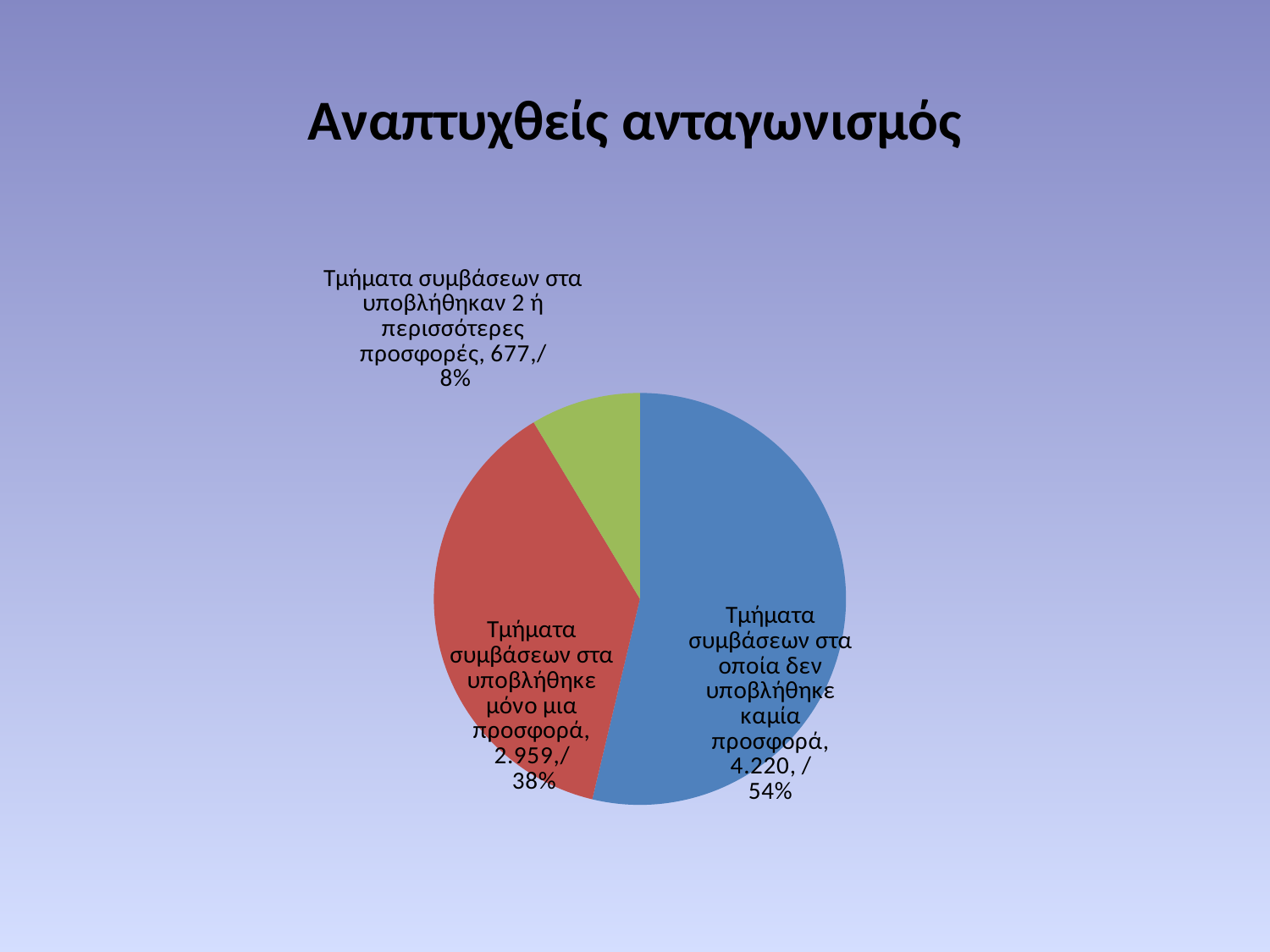
Which colour is the slice for 'Τμήματα συμβάσεων στα υποβλήθηκε μόνο μια προσφορά'? Red How many slices does the pie chart have? 3 What is the value for 'Τμήματα συμβάσεων στα υποβλήθηκε μόνο μια προσφορά'? 2.959 What is the value for 'Τμήματα συμβάσεων στα υποβλήθηκαν 2 ή περισσότερες προσφορές'? 677 What share of the pie is 'Τμήματα συμβάσεων στα υποβλήθηκαν 2 ή περισσότερες προσφορές'? 8% Which category has the largest slice? Τμήματα συμβάσεων στα οποία δεν υποβλήθηκε καμία προσφορά What is the title of the chart? Αναπτυχθείς ανταγωνισμός What is the difference between the value for 'Τμήματα συμβάσεων στα οποία δεν υποβλήθηκε καμία προσφορά' and the value for 'Τμήματα συμβάσεων στα υποβλήθηκε μόνο μια προσφορά'? 1.261 What kind of chart is shown on the slide? Pie chart What share of the pie is 'Τμήματα συμβάσεων στα οποία δεν υποβλήθηκε καμία προσφορά'? 54% Which category has the smallest slice? Τμήματα συμβάσεων στα υποβλήθηκαν 2 ή περισσότερες προσφορές What is the value for 'Τμήματα συμβάσεων στα οποία δεν υποβλήθηκε καμία προσφορά'? 4.220